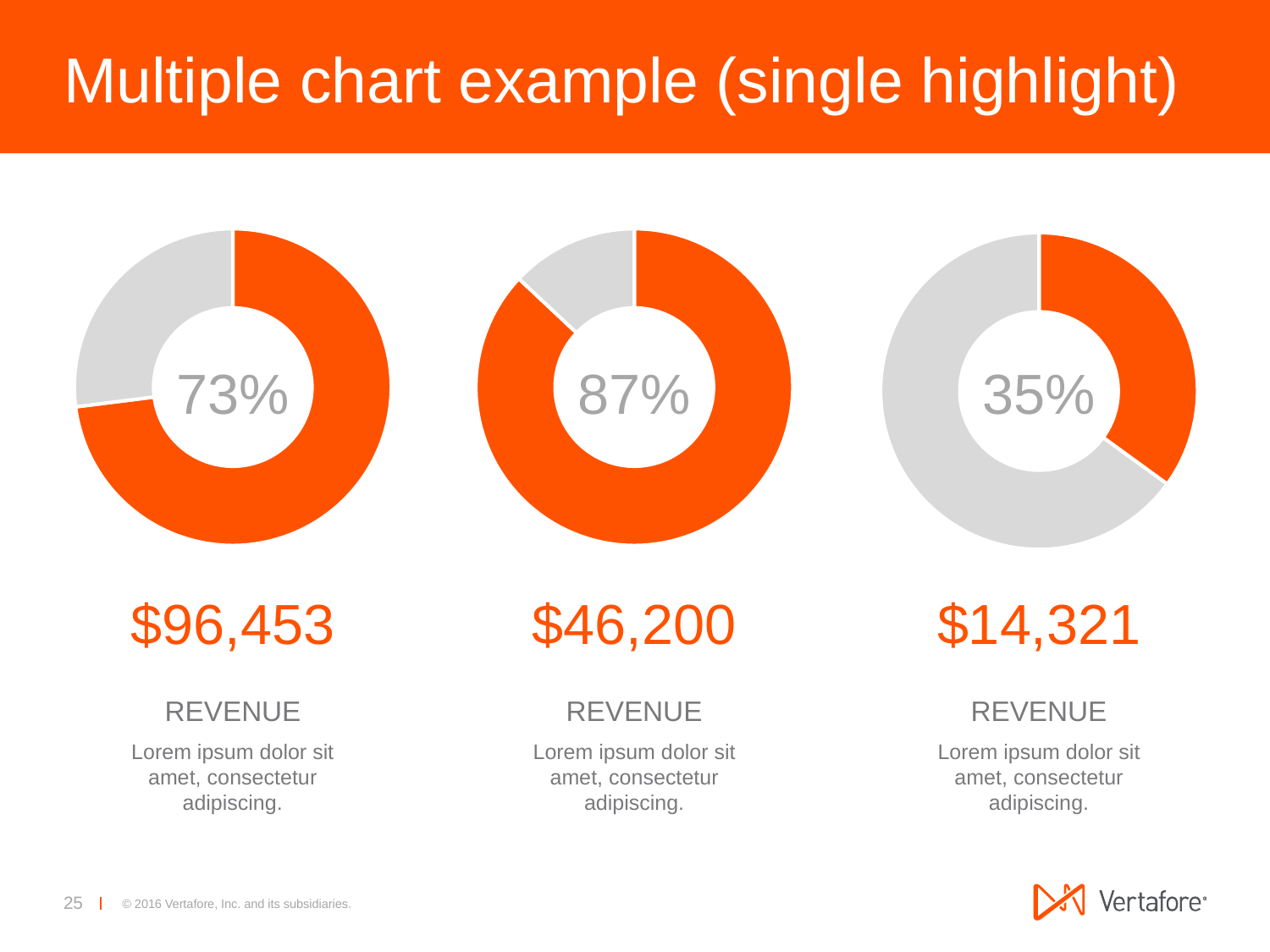
What kind of chart is shown on the left of the slide? Donut chart What percentage is shown in the centre of the middle donut chart? 87% Which of the three donut charts shows the highest percentage? The middle chart (87%) How many donut charts are on the slide? 3 Is the percentage in the left donut chart larger or smaller than the percentage in the middle donut chart? Smaller What percentage is shown in the centre of the right donut chart? 35% What revenue figure is printed below the right donut chart? $14,321 What is the difference between the percentage in the middle donut chart and the percentage in the right donut chart? 52% What revenue figure is printed below the left donut chart? $96,453 What percentage is shown in the centre of the left donut chart? 73% In the right donut chart, what colour is the highlighted 35% segment? Orange Which of the three donut charts shows the lowest percentage? The right chart (35%)